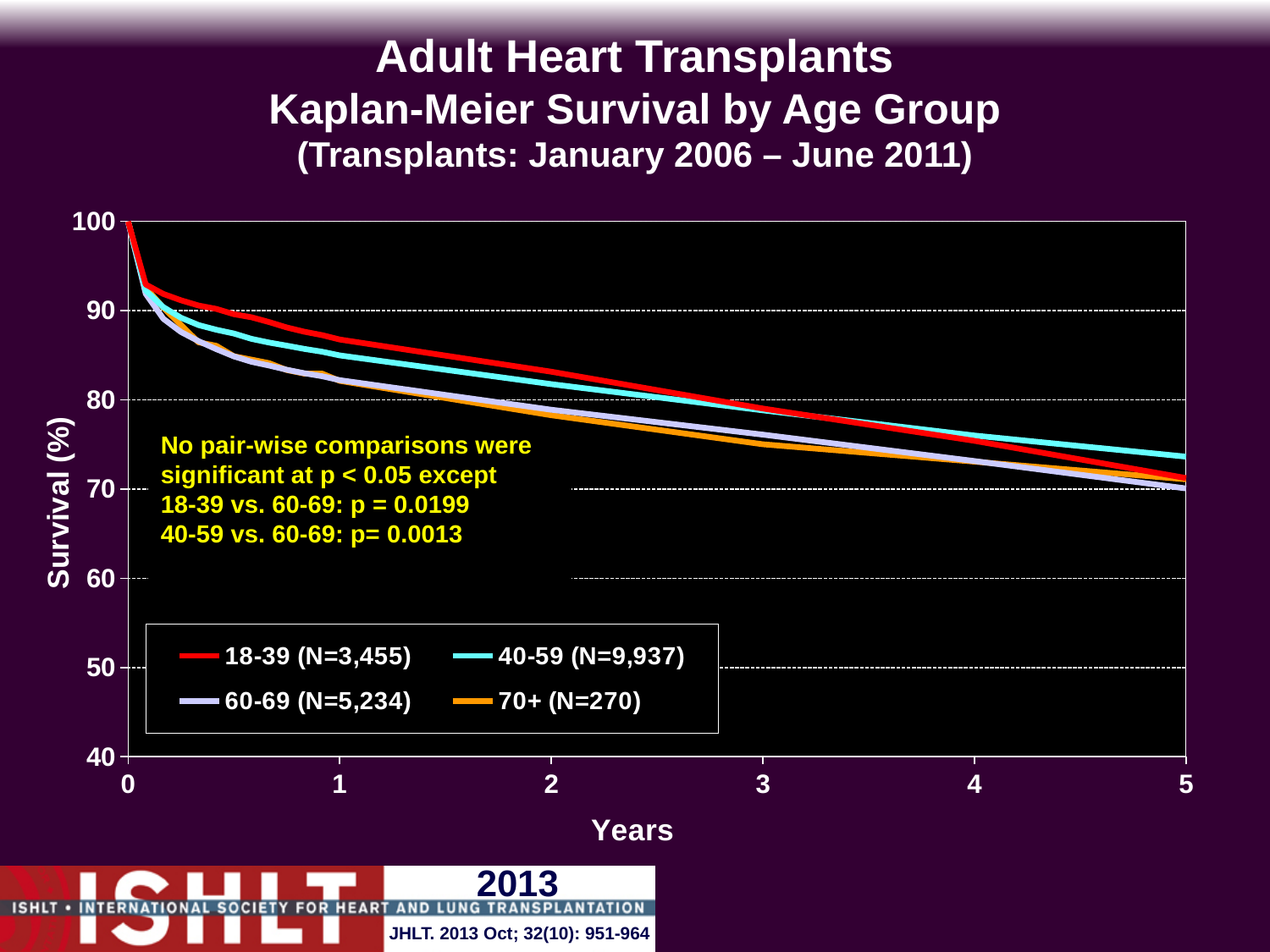
Is the survival for the 40-59 group at 5 years greater or less than 70? greater What is the N for the 70+ age group shown in the legend? N=270 What p-value is given for the 40-59 vs. 60-69 comparison? p= 0.0013 Which age group has the highest survival at 5 years? 40-59 What kind of chart is shown on the slide? line chart Is the survival for the 18-39 group at 1 year greater or less than 90? less Is the survival for the 70+ group at 3 years greater or less than 80? less How many series does the legend list? 4 At 1 year, which group has higher survival, 18-39 or 70+? 18-39 At 5 years, which group has higher survival, 40-59 or 60-69? 40-59 Do the survival curves rise or fall as years increase? fall